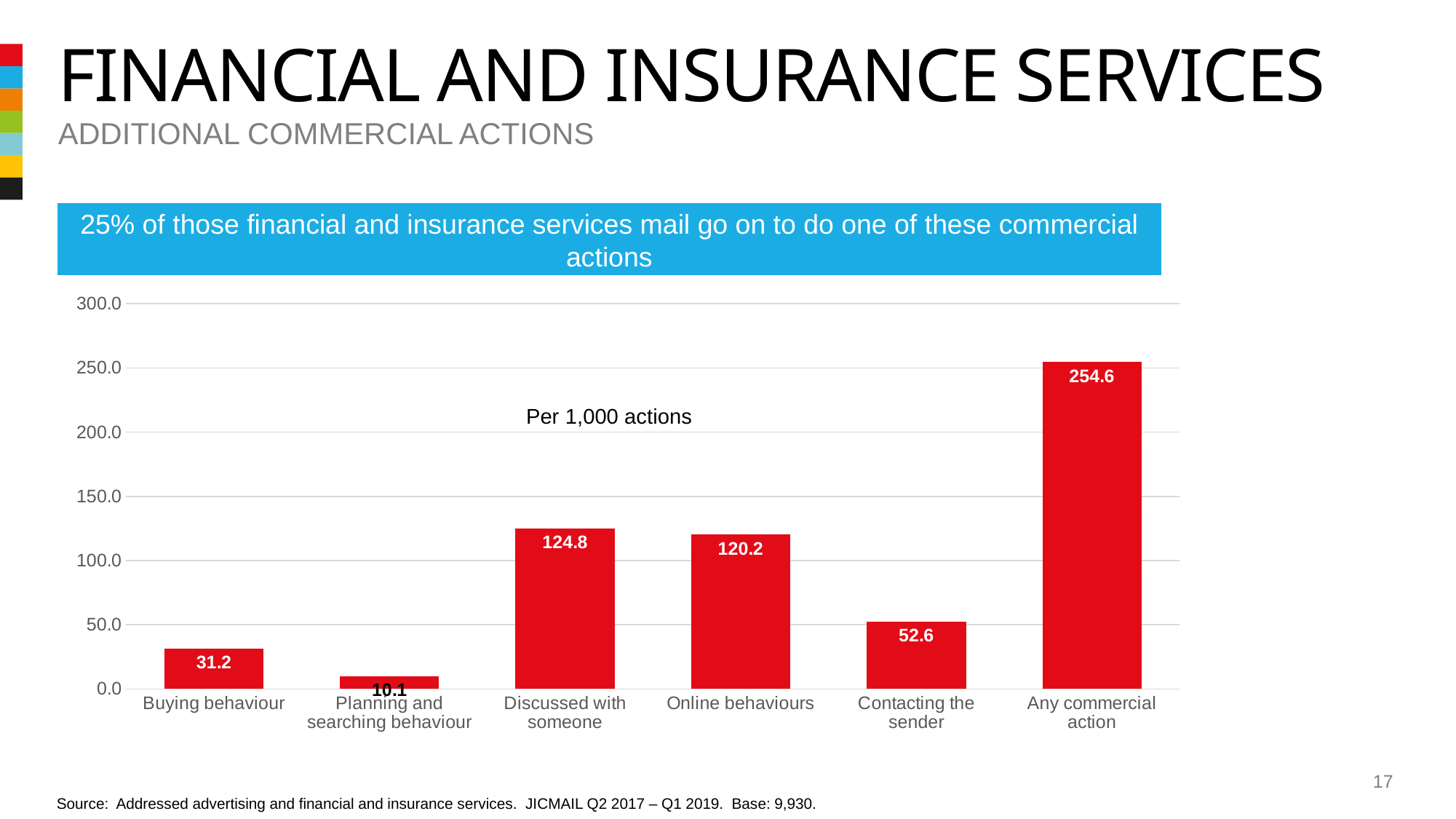
What is the value for Contacting the sender? 52.6 What kind of chart is shown on the slide? Bar chart What is the value for Buying behaviour? 31.2 What is the difference between Discussed with someone and Online behaviours? 4.6 Is the value for Online behaviours greater or less than 100.0? greater What is the value for Any commercial action? 254.6 What unit label is printed on the chart? Per 1,000 actions Which category has the lowest value? Planning and searching behaviour Which category has the highest value? Any commercial action What is the value for Discussed with someone? 124.8 How many categories are shown on the chart? 6 Which is larger, Buying behaviour or Contacting the sender? Contacting the sender